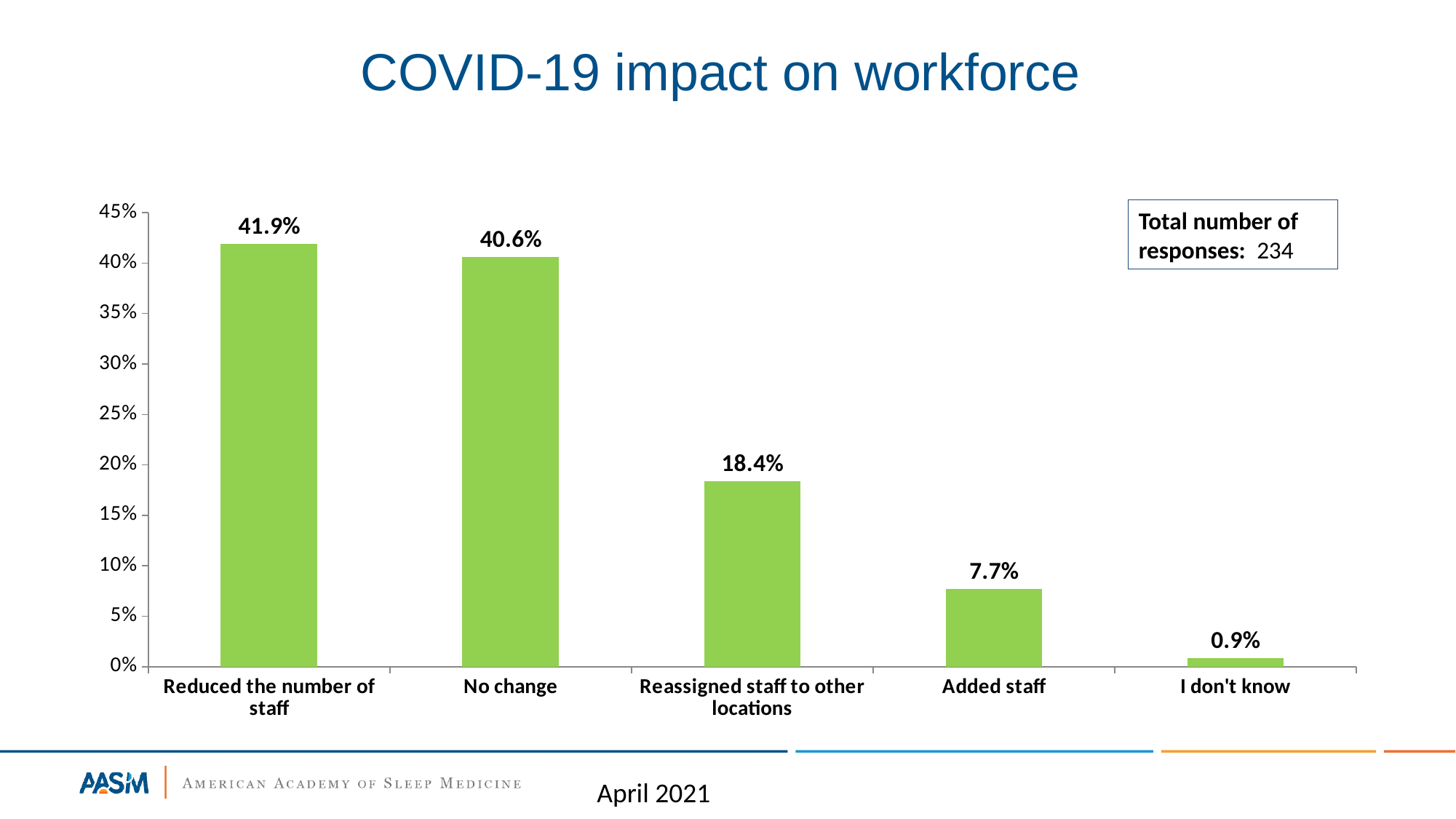
What is the value for 'I don't know'? 0.9% What is the value for 'Reassigned staff to other locations'? 18.4% What percentage of respondents reported they reduced the number of staff? 41.9% What is the difference between 'Reassigned staff to other locations' and 'Added staff'? 10.7% Which category has the lowest value? I don't know Which category has the highest value? Reduced the number of staff What percentage of respondents said they added staff? 7.7% Which is larger: the value for 'Reassigned staff to other locations' or the value for 'Added staff'? Reassigned staff to other locations What kind of chart is shown on the slide? Bar chart What is the total number of responses stated on the slide? 234 How many categories are shown on the x axis? 5 What is the difference between 'Reduced the number of staff' and 'No change'? 1.3%